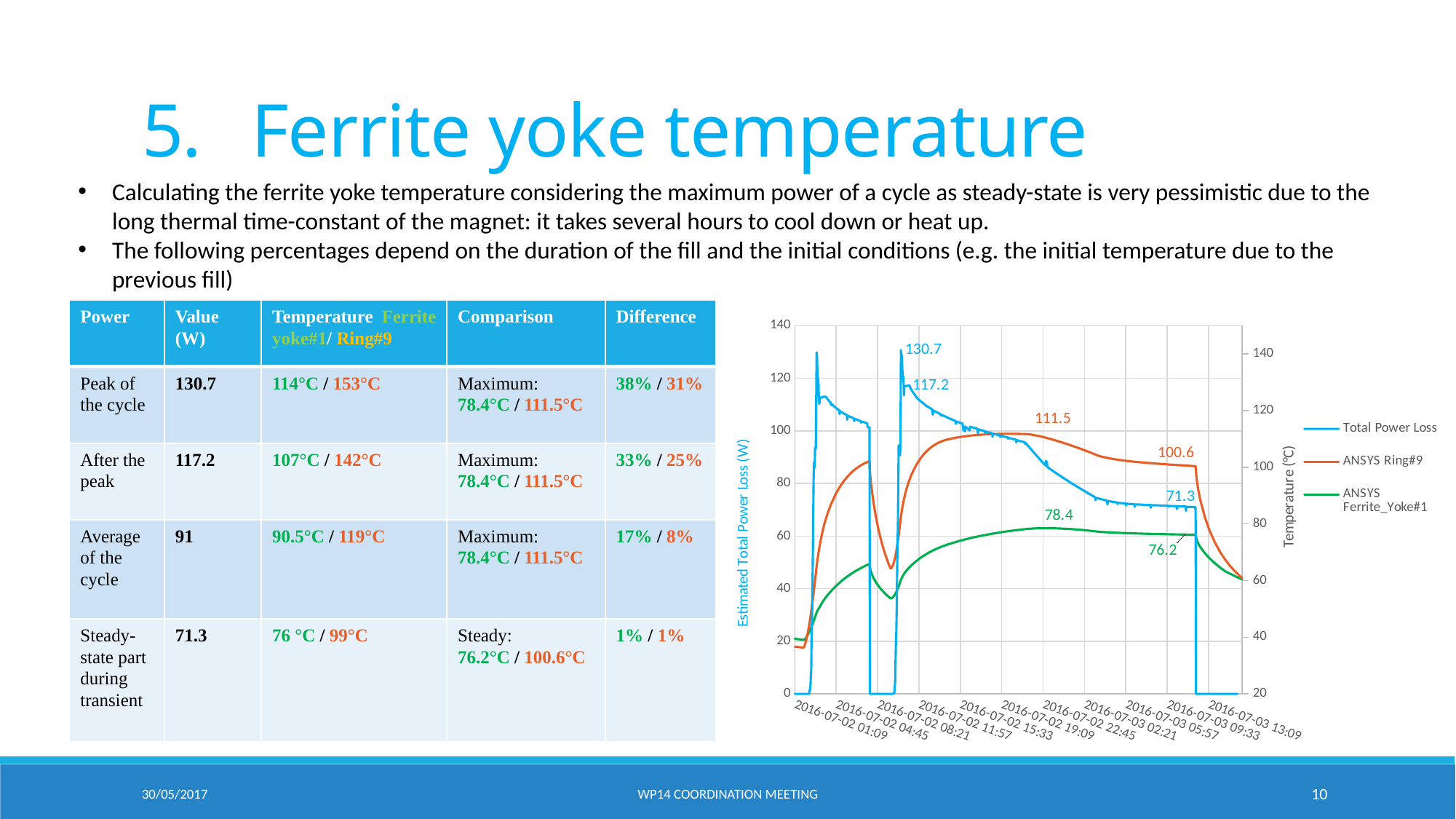
What is the highest labelled value of the ANSYS Ring#9 series? 111.5 What is the labelled value of the ANSYS Ring#9 series just before it drops at the right of the chart? 100.6 What is the difference between the two labelled values of the Total Power Loss series at its peak, 130.7 and 117.2? 13.5 What kind of chart is shown on the slide? line chart How many series does the chart legend list? 3 Which series reaches a higher labelled maximum, ANSYS Ring#9 or ANSYS Ferrite_Yoke#1? ANSYS Ring#9 What is the labelled value of the Total Power Loss series just after its peak? 117.2 What is the highest labelled value of the ANSYS Ferrite_Yoke#1 series? 78.4 What are the three series listed in the chart legend? Total Power Loss, ANSYS Ring#9, ANSYS Ferrite_Yoke#1 What is the difference between the labelled maximum of ANSYS Ring#9 (111.5) and its later labelled value (100.6)? 10.9 What is the highest labelled value of the Total Power Loss series? 130.7 What is the title of the left vertical axis of the chart? Estimated Total Power Loss (W)